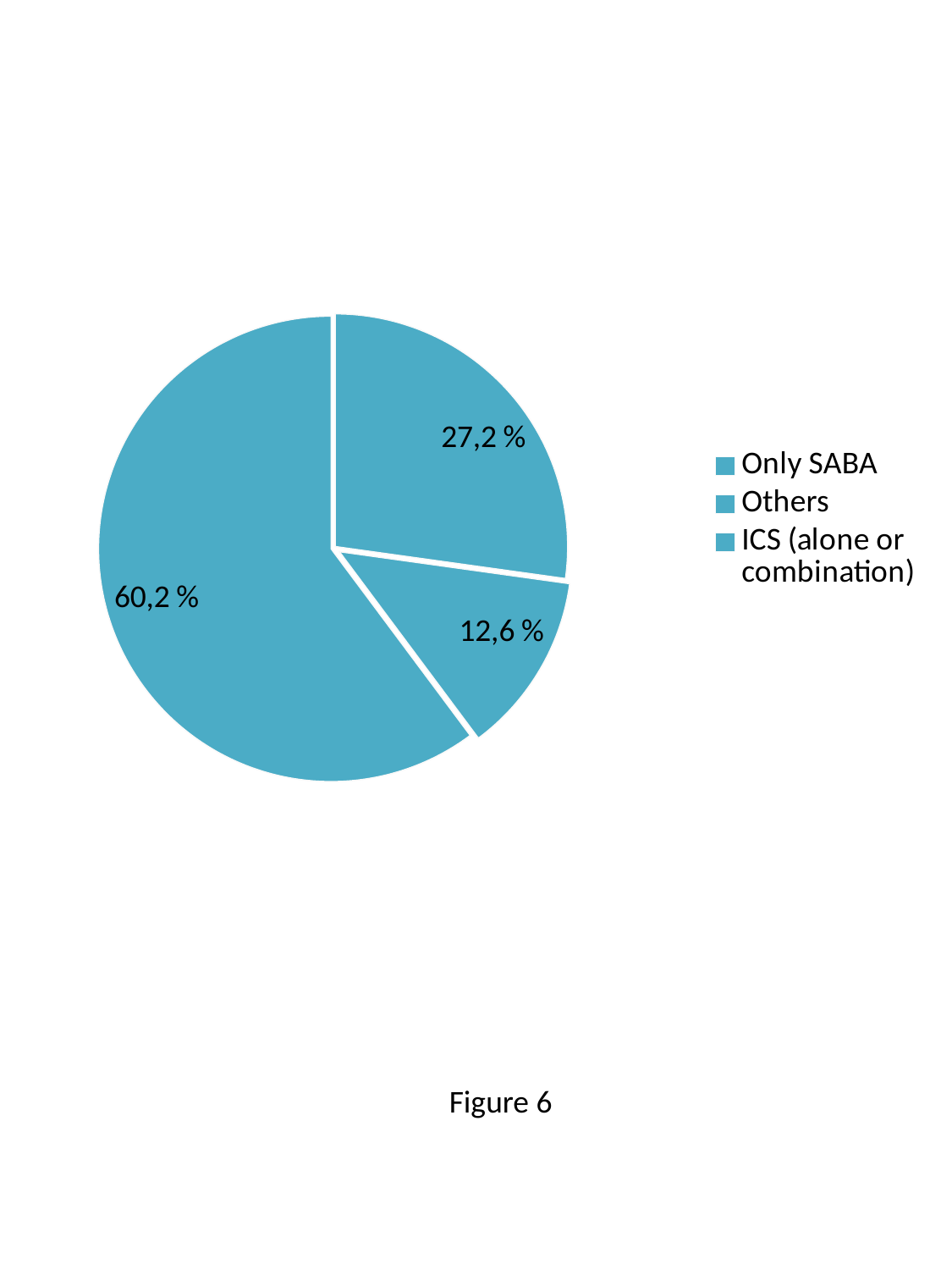
How many entries does the legend of the pie chart list? 3 What is the percentage shown on the largest slice of the pie chart? 60,2 % How many slices does the pie chart have? 3 What is the difference between the 27,2 % slice and the 12,6 % slice of the pie chart? 14,6 % Is the largest slice of the pie chart greater or less than 50%? greater What is the third entry listed in the legend of the pie chart? ICS (alone or combination) What is the figure caption shown below the pie chart? Figure 6 What kind of chart is shown on the slide? pie chart What is the percentage shown on the smallest slice of the pie chart? 12,6 % What is the difference between the largest slice (60,2 %) and the smallest slice (12,6 %) of the pie chart? 47,6 % Which is larger in the pie chart: the slice labelled 27,2 % or the slice labelled 12,6 %? 27,2 %